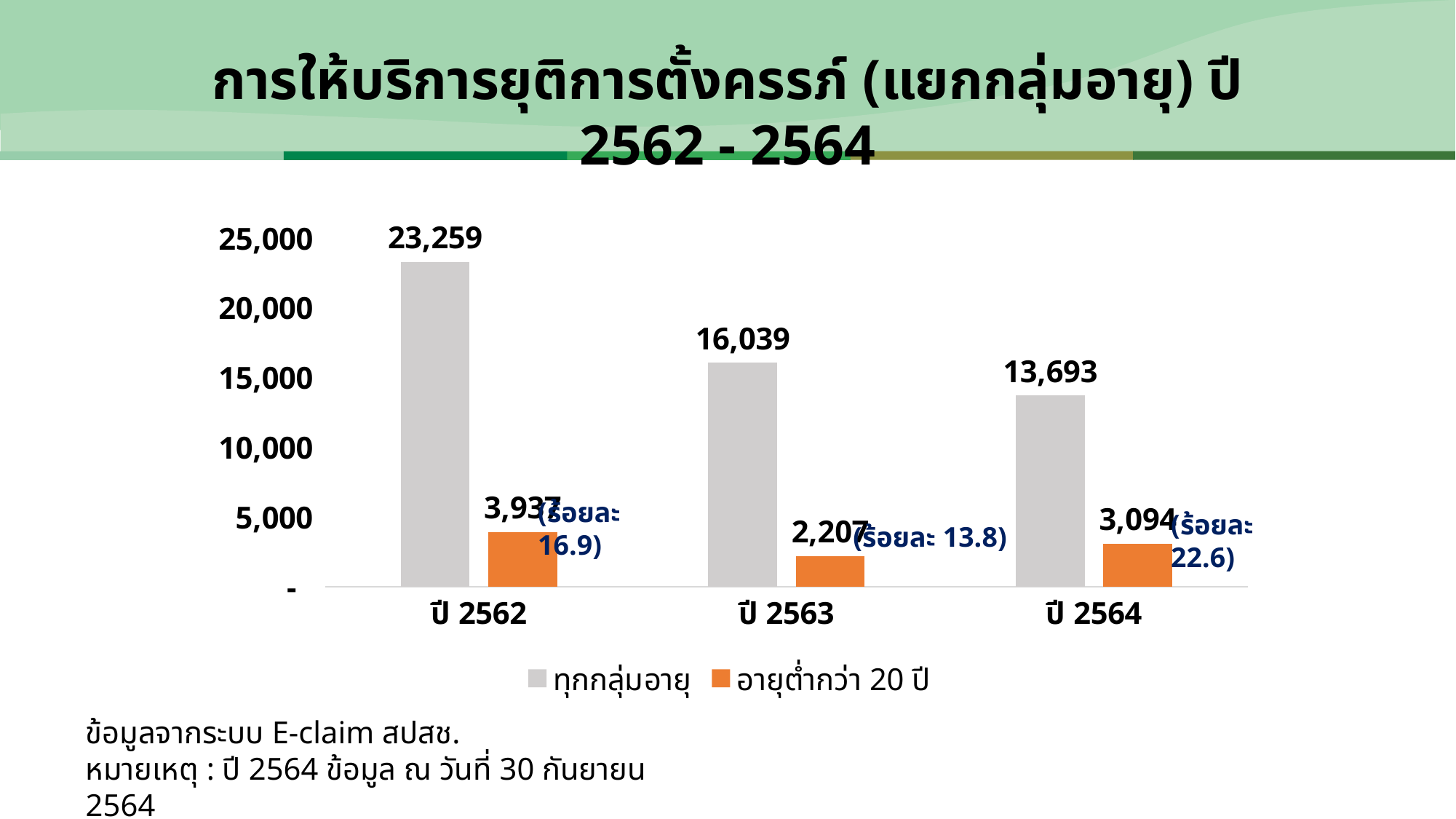
Which year has the highest value for ทุกกลุ่มอายุ? ปี 2562 Is the value for ทุกกลุ่มอายุ in ปี 2563 greater or less than 15,000? greater What is the difference between the ทุกกลุ่มอายุ values for ปี 2562 and ปี 2563? 7,220 What percentage is shown next to the อายุต่ำกว่า 20 ปี bar for ปี 2564? ร้อยละ 22.6 How many series does the legend list? 2 What is the value for ทุกกลุ่มอายุ in ปี 2562? 23,259 How many years are shown on the x axis? 3 Which year has the lowest value for อายุต่ำกว่า 20 ปี? ปี 2563 What kind of chart is shown on the slide? bar chart What is the value for อายุต่ำกว่า 20 ปี in ปี 2563? 2,207 Which is larger: the อายุต่ำกว่า 20 ปี value for ปี 2562 or for ปี 2564? ปี 2562 What is the value for ทุกกลุ่มอายุ in ปี 2564? 13,693